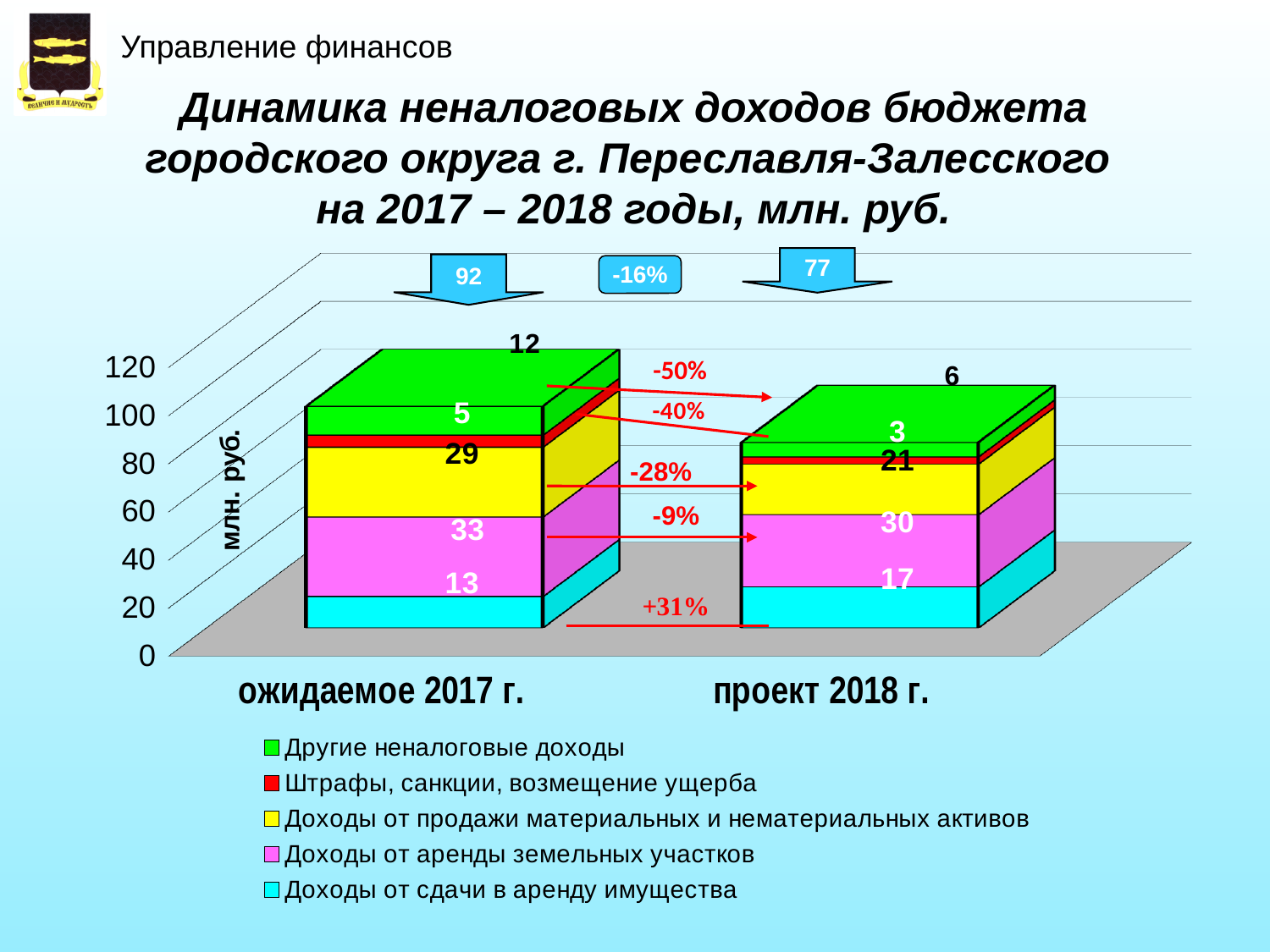
What is the difference between 'Доходы от продажи материальных и нематериальных активов' in 2017 and in 2018? 8 Which series has the lowest value in 'ожидаемое 2017 г.'? Штрафы, санкции, возмещение ущерба How many series does the legend list? 5 What is the value for 'Доходы от аренды земельных участков' in 'ожидаемое 2017 г.'? 33 What is the value for 'Доходы от сдачи в аренду имущества' in 'проект 2018 г.'? 17 What is the value for 'Доходы от продажи материальных и нематериальных активов' in 'проект 2018 г.'? 21 What is the total of the stacked bar for 'проект 2018 г.'? 77 Which is larger: 'Доходы от сдачи в аренду имущества' in 'ожидаемое 2017 г.' or in 'проект 2018 г.'? проект 2018 г. What is the value for 'Штрафы, санкции, возмещение ущерба' in 'ожидаемое 2017 г.'? 5 Which series has the highest value in 'проект 2018 г.'? Доходы от аренды земельных участков What is the total of the stacked bar for 'ожидаемое 2017 г.'? 92 What kind of chart is shown on the slide? Stacked bar chart